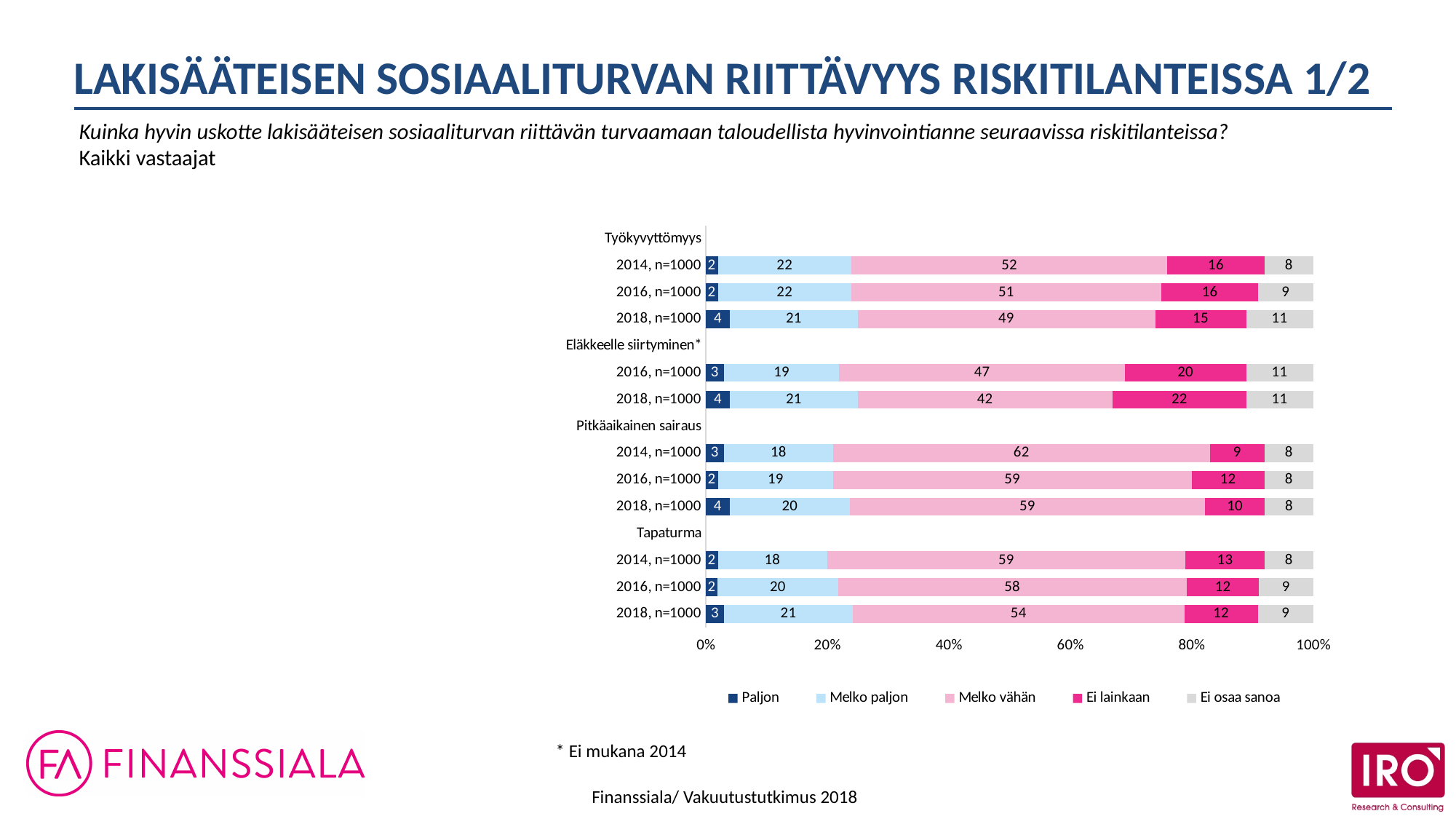
Which is larger: the 'Ei lainkaan' value for Työkyvyttömyys 2018 or for Eläkkeelle siirtyminen 2018? Eläkkeelle siirtyminen 2018 What is the total of the 'Paljon' and 'Melko paljon' segments for Tapaturma in 2018, n=1000? 24 What is the 'Ei osaa sanoa' value for Tapaturma in 2016, n=1000? 9 Which legend entry is shown in dark blue? Paljon Which bar has the lowest 'Ei lainkaan' value? Pitkäaikainen sairaus, 2014, n=1000 What is the 'Ei lainkaan' value for Eläkkeelle siirtyminen in 2018, n=1000? 22 What is the difference between the 'Melko vähän' values for Eläkkeelle siirtyminen in 2016 and 2018? 5 Which bar has the highest 'Melko vähän' value? Pitkäaikainen sairaus, 2014, n=1000 What is the 'Melko vähän' value for Työkyvyttömyys in 2014, n=1000? 52 What type of chart is shown on the slide? Stacked bar chart How many bars (year rows) are plotted in the chart? 11 How many series does the legend list? 5